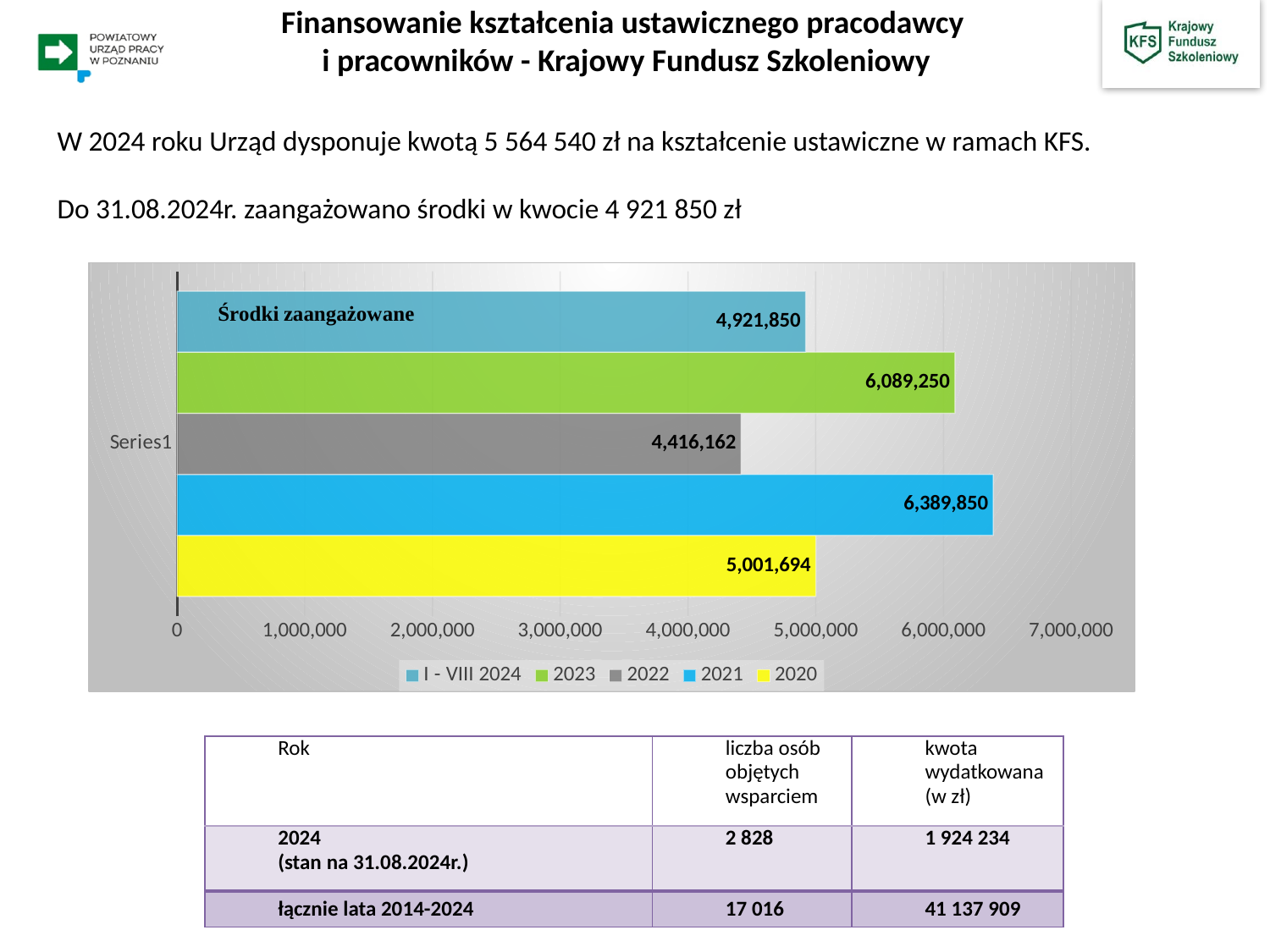
Which series has the highest value in the chart? 2021 Is the value for 2021 greater or less than 6,000,000? greater What kind of chart is shown on the slide? bar chart Which series has the lowest value in the chart? 2022 What is the value for 2022 in the chart? 4,416,162 Which is larger, the value for 2020 or the value for 2022? 2020 How many series does the legend list? 5 What is the difference between the values for 2021 and 2023? 300,600 What is the value for 2020 in the chart? 5,001,694 What is the value for I - VIII 2024 in the chart? 4,921,850 What is the difference between the values for 2020 and I - VIII 2024? 79,844 What is the value for 2023 in the chart? 6,089,250